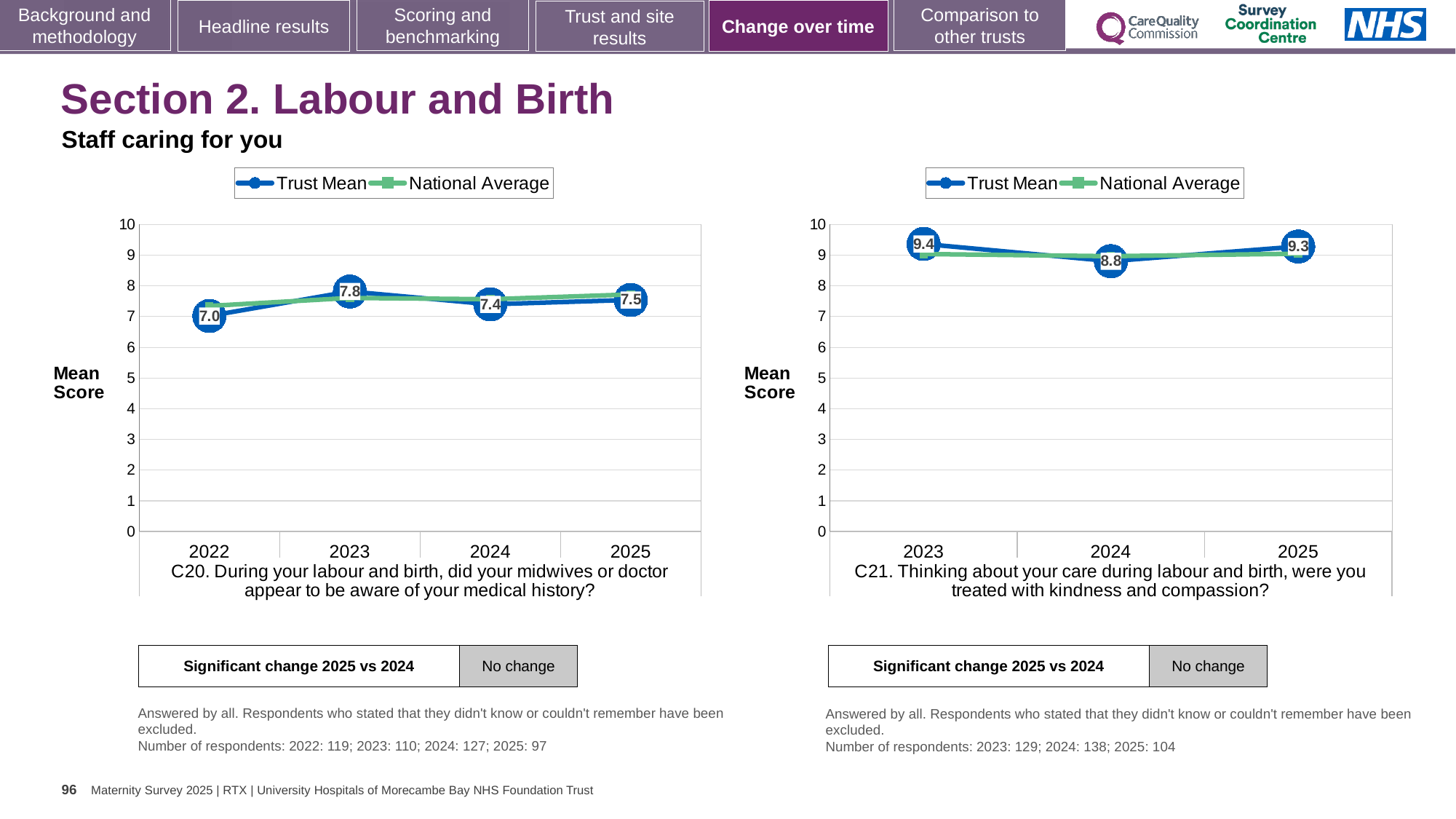
What kind of chart is the C20 chart (left)? Line chart In the C21 chart (right), is the Trust Mean score for 2023 or 2025 larger? 2023 In the C20 chart (left), what is the Trust Mean score for 2022? 7.0 In the C20 chart (left), what is the difference between the Trust Mean scores for 2023 and 2022? 0.8 In the C21 chart (right), which year has the lowest Trust Mean score? 2024 In the C21 chart (right), is the Trust Mean value for 2024 greater or less than 8? greater In the C20 chart (left), how many years are plotted on the x axis? 4 In the C20 chart (left), which year has the lowest Trust Mean score? 2022 In the C20 chart (left), what is the Trust Mean score for 2025? 7.5 In the C20 chart (left), which year has the highest Trust Mean score? 2023 In the C21 chart (right), what is the Trust Mean score for 2024? 8.8 How many series does the legend of the C21 chart (right) list? 2